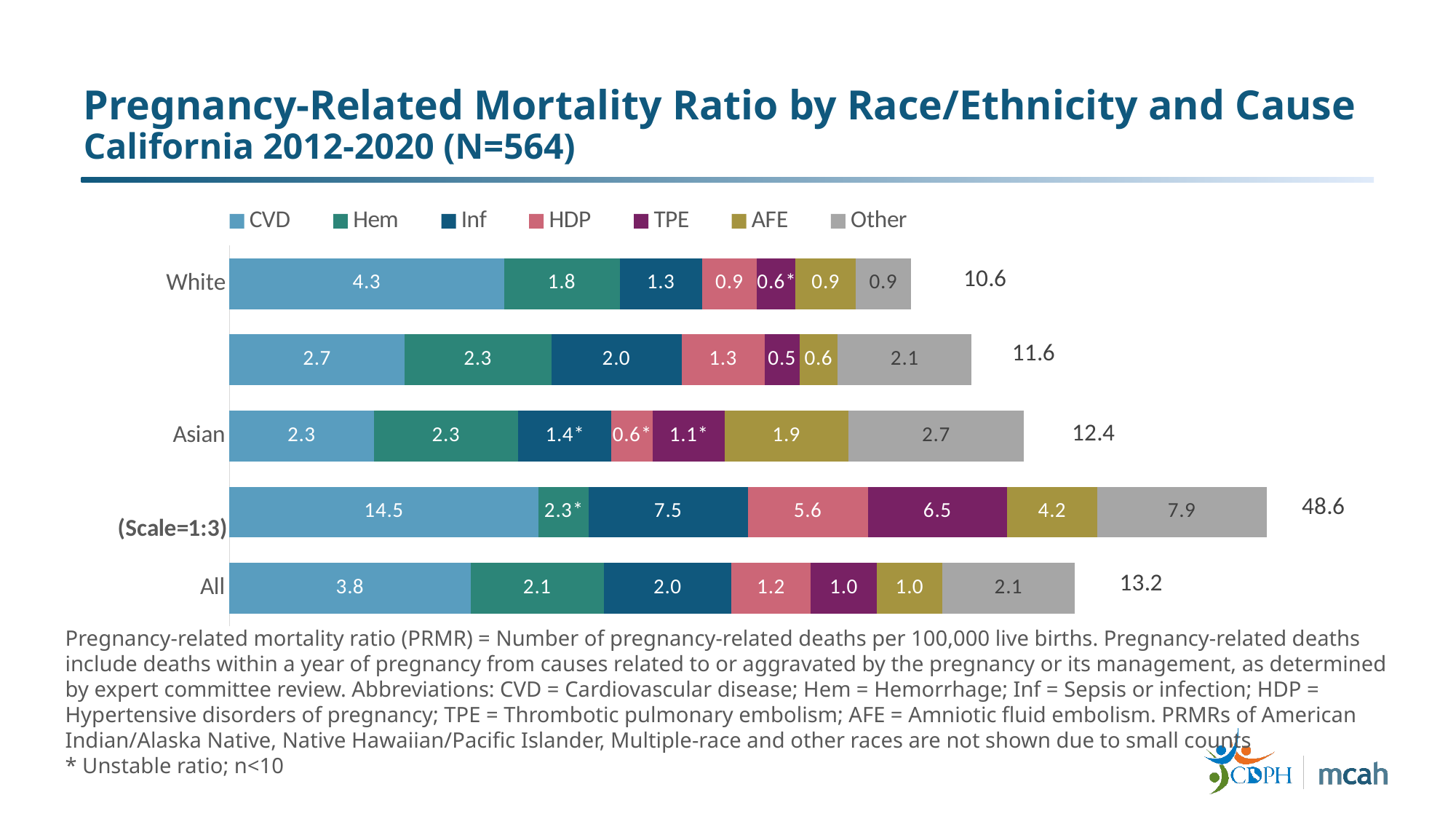
What is the Inf value for All? 2.0 What is the total pregnancy-related mortality ratio shown for All? 13.2 What is the Other value for Asian? 2.7 What is the total pregnancy-related mortality ratio shown for White? 10.6 What is the AFE value for Asian? 1.9 How many bars are plotted in the chart? 5 What kind of chart is shown on the slide? Stacked bar chart How many series does the legend list? 7 What is the CVD value for White? 4.3 Which is larger, the CVD value for White or the CVD value for Asian? White Which cause has the largest value in the All bar? CVD What is the difference between the Hem value for All and the Hem value for White? 0.3